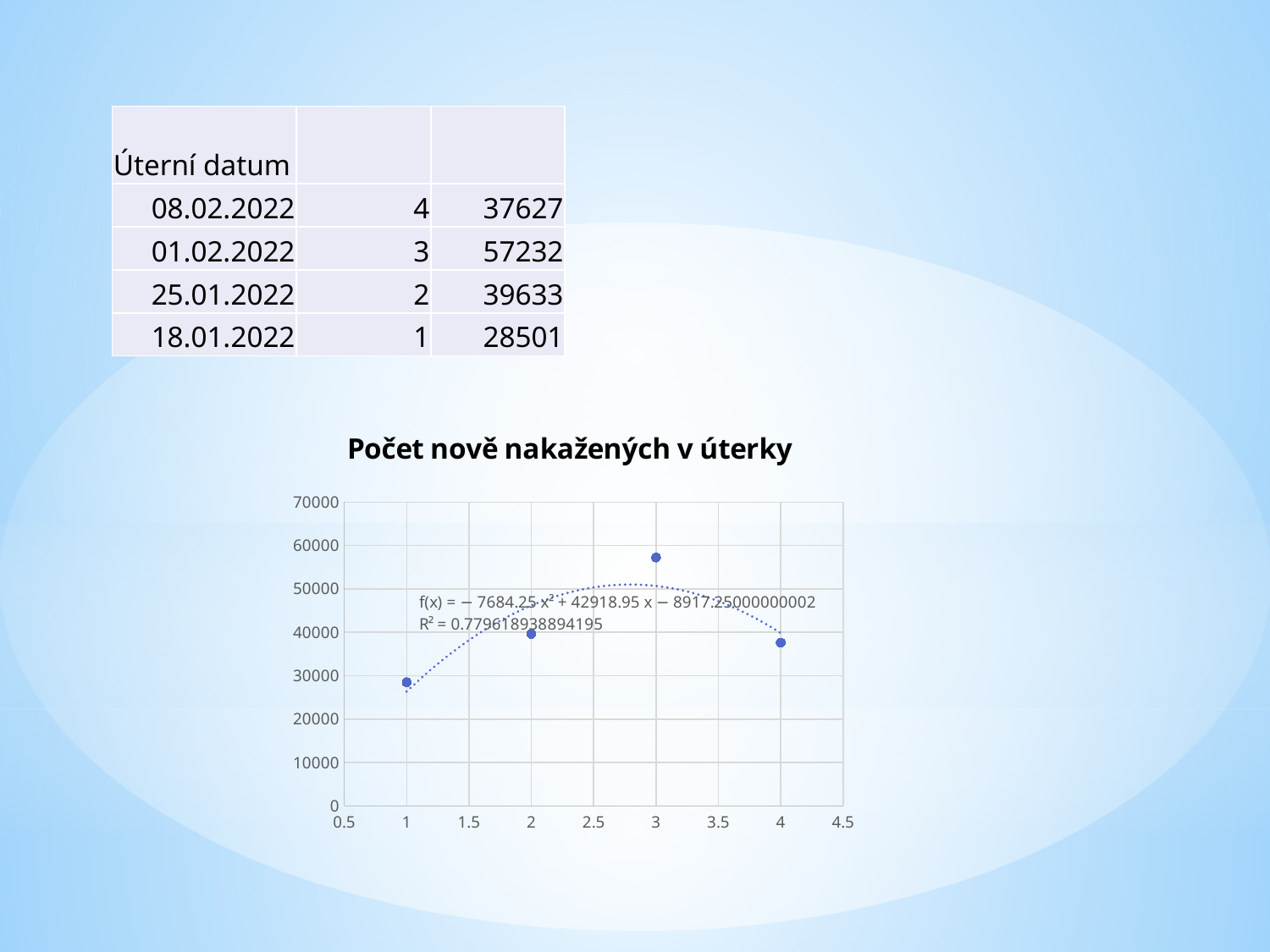
At which x value does the chart have its lowest point? 1 Is the value at x = 2 greater or less than 30000? greater What R² value is printed on the chart for the trendline? 0.779618938894195 Which point is higher, the one at x = 3 or the one at x = 4? x = 3 How do the values change from x = 1 to x = 4 in the chart? They rise from x = 1 to x = 3, then fall at x = 4 What kind of chart is shown on the slide? scatter chart Is the value at x = 3 greater or less than 50000? greater At which x value does the chart reach its highest point? 3 Is the value at x = 4 greater or less than 40000? less How many data points are plotted in the chart? 4 What is the title of the chart? Počet nově nakažených v úterky